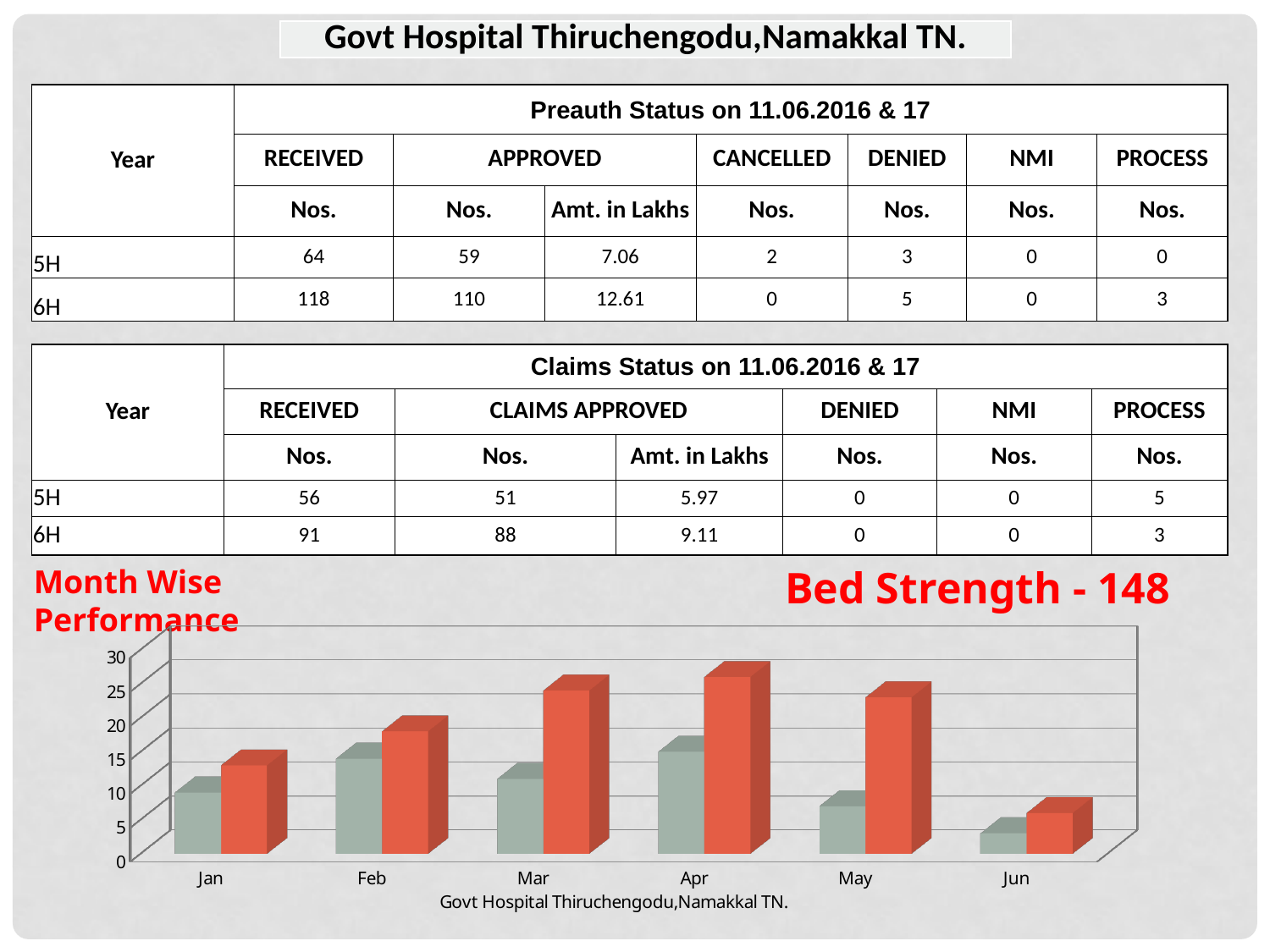
What kind of chart is shown under the heading "Month Wise Performance"? bar chart In the Month Wise Performance chart, which month has the shortest grey bar? Jun How many months are shown on the x axis of the Month Wise Performance chart? 6 In the Month Wise Performance chart, is the red bar for Apr greater or less than 20? greater What text appears below the x axis of the Month Wise Performance chart? Govt Hospital Thiruchengodu,Namakkal TN. In the Month Wise Performance chart, which is larger: the grey bar for Jan or the grey bar for Jun? Jan In the Month Wise Performance chart, which is larger: the red bar for Mar or the red bar for Feb? Mar In the Month Wise Performance chart, which month has the shortest red bar? Jun In the Month Wise Performance chart, which month has the tallest red bar? Apr In the Month Wise Performance chart, is the grey bar for May greater or less than 10? less In the Month Wise Performance chart, is the red bar for Feb greater or less than 15? greater